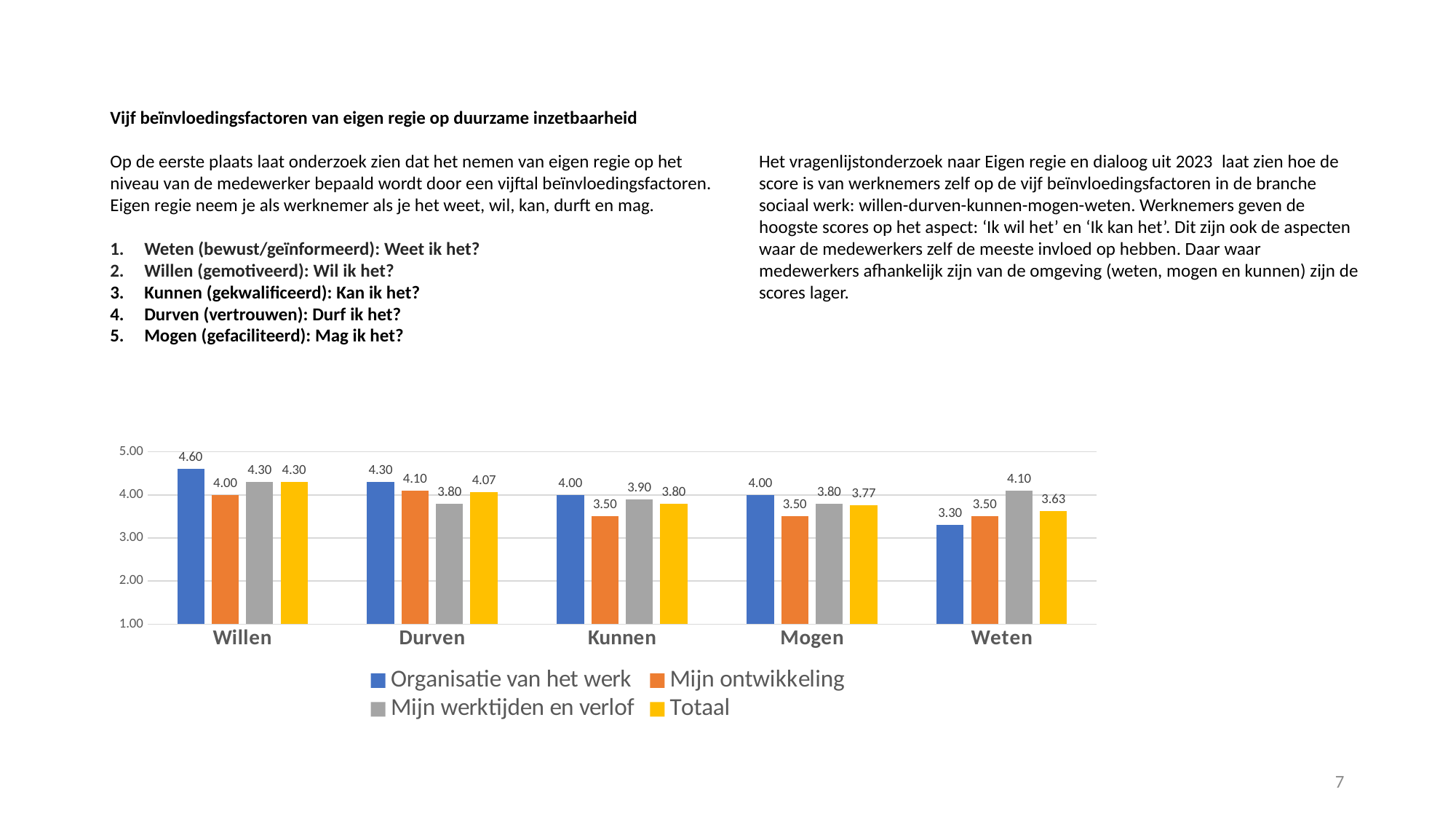
What is the difference between the Organisatie van het werk values for Willen and Weten? 1.30 Is the Totaal value for Weten greater or less than 4.00? less What kind of chart is shown on the slide? bar chart What is the Totaal value for Durven? 4.07 How many series does the legend list? 4 What is the value for Mijn werktijden en verlof in the Weten category? 4.10 Which colour represents the Totaal series in the chart? yellow Which is larger: Mijn ontwikkeling for Durven or Mijn ontwikkeling for Kunnen? Durven What is the value for Organisatie van het werk in the Willen category? 4.60 Which category has the lowest value for Organisatie van het werk? Weten How many categories are shown on the x axis? 5 Which category has the highest Totaal value? Willen